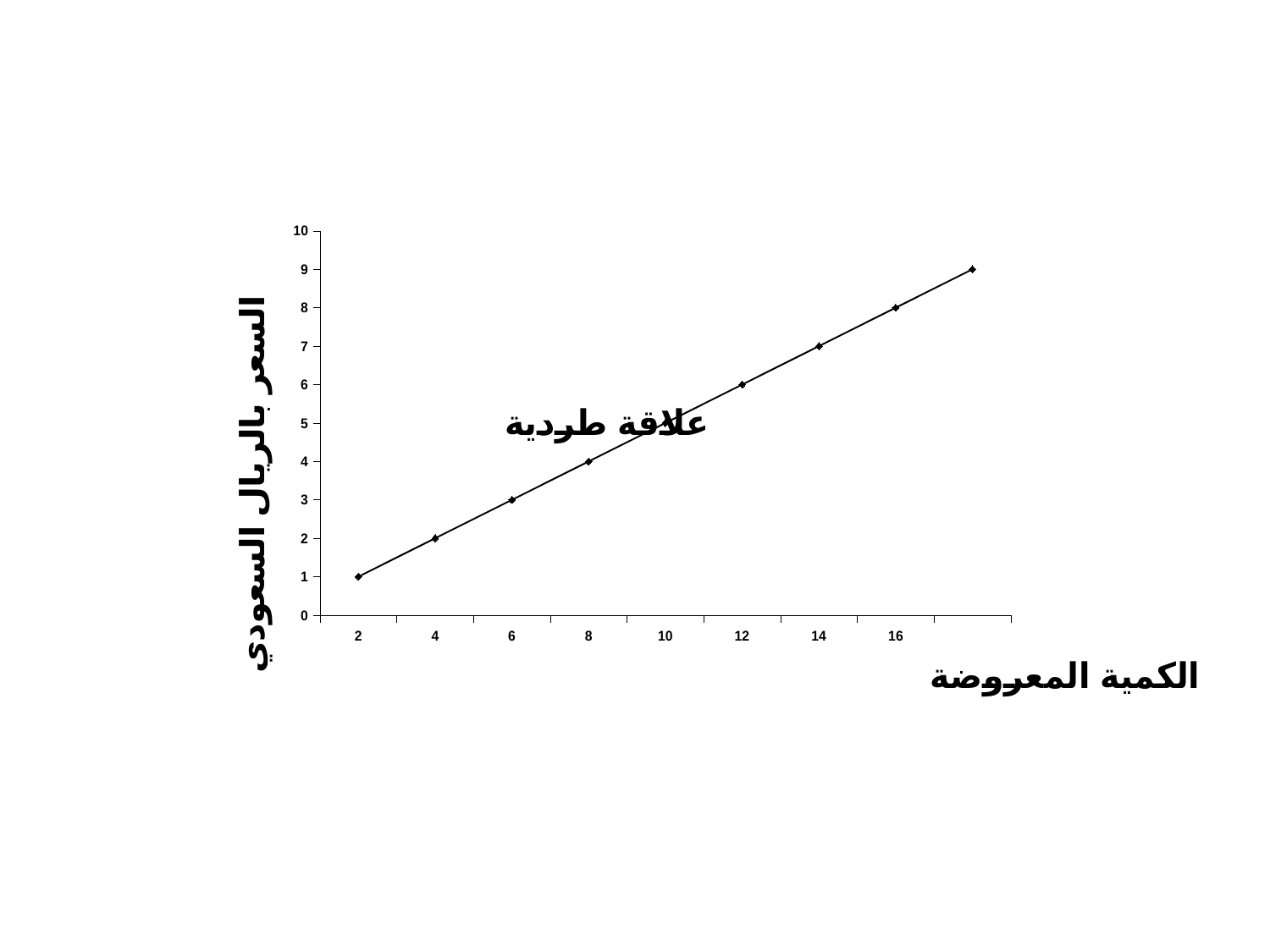
What is the price (y value) when the quantity supplied is 12? 6 Which labeled quantity on the x axis has the lowest price value? 2 What is the title of the x axis? الكمية المعروضة Is the price at quantity 14 greater or less than 5? greater What is the price (y value) when the quantity supplied is 8? 4 What kind of chart is shown on the slide? line chart What text is written on the chart next to the line? علاقة طردية What is the price (y value) when the quantity supplied is 2? 1 Do the values rise or fall as the quantity supplied increases along the x axis? rise What is the price (y value) when the quantity supplied is 16? 8 Which is larger, the price at quantity 6 or the price at quantity 14? the price at quantity 14 What is the difference between the price at quantity 16 and the price at quantity 2? 7